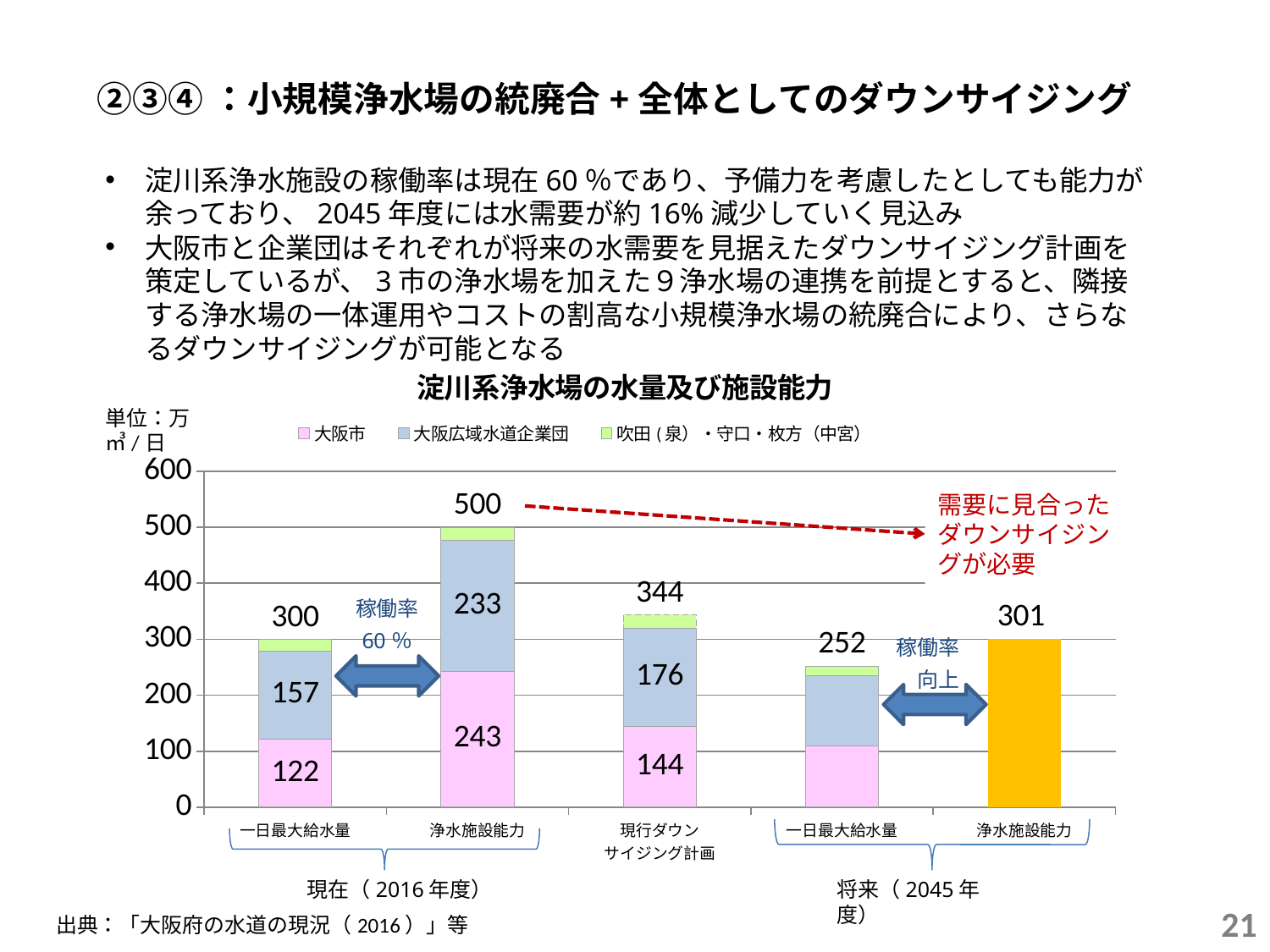
What kind of chart is shown under the title 淀川系浄水場の水量及び施設能力? Stacked bar chart How many series does the legend of the chart list? 3 Is the 大阪市 segment of the 一日最大給水量 bar for 将来（2045年度） greater or less than 200? less What is the total value labelled on the 浄水施設能力 bar for 現在（2016年度）? 500 What is the difference between the 浄水施設能力 total (500) and the 一日最大給水量 total (300) for 現在（2016年度）? 200 Which bar has the lowest total value? 一日最大給水量 (将来 2045年度), 252 Which bar has the highest total value? 浄水施設能力 (現在 2016年度), 500 Which is larger: the 大阪市 value in the 現在 浄水施設能力 bar or the 大阪市 value in the 現行ダウンサイジング計画 bar? 現在 浄水施設能力 (243) What is the 大阪広域水道企業団 value in the 現行ダウンサイジング計画 bar? 176 What is the 大阪市 value in the 一日最大給水量 bar for 現在（2016年度）? 122 What is the difference between the 現行ダウンサイジング計画 total (344) and the 将来 浄水施設能力 total (301)? 43 How many bars are plotted in the chart? 5